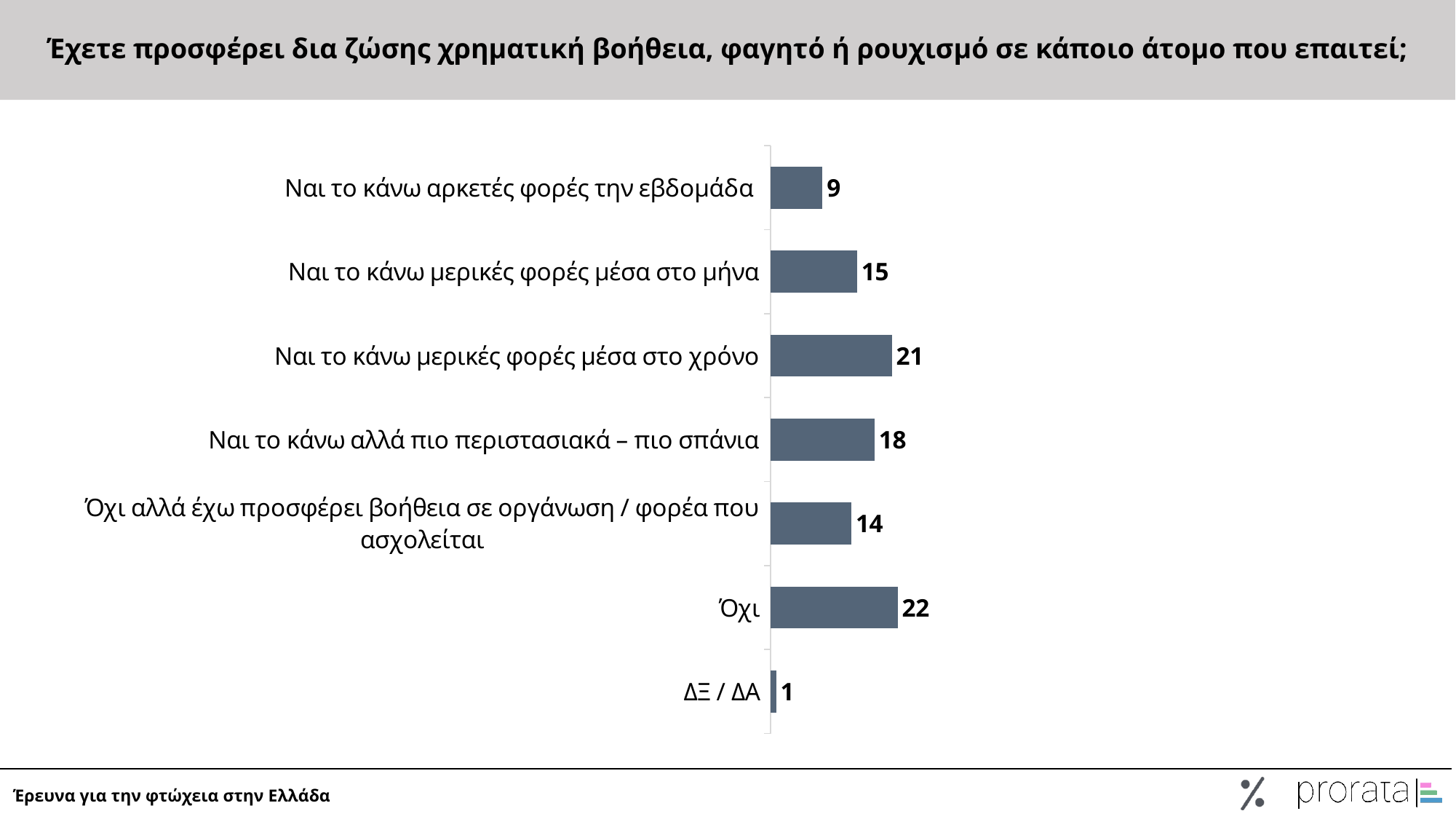
Which category has the highest value? Όχι What is the title of the chart? Έχετε προσφέρει δια ζώσης χρηματική βοήθεια, φαγητό ή ρουχισμό σε κάποιο άτομο που επαιτεί; What kind of chart is shown on the slide? Bar chart What is the difference between the values for 'Όχι' and 'Ναι το κάνω αρκετές φορές την εβδομάδα'? 13 Which is larger: the value for 'Ναι το κάνω αλλά πιο περιστασιακά – πιο σπάνια' or the value for 'Ναι το κάνω μερικές φορές μέσα στο μήνα'? Ναι το κάνω αλλά πιο περιστασιακά – πιο σπάνια How many categories are shown in the chart? 7 Which category has the lowest value? ΔΞ / ΔΑ What is the value for 'Ναι το κάνω μερικές φορές μέσα στο μήνα'? 15 What is the value for 'Ναι το κάνω μερικές φορές μέσα στο χρόνο'? 21 What is the difference between the values for 'Ναι το κάνω μερικές φορές μέσα στο χρόνο' and 'Ναι το κάνω αλλά πιο περιστασιακά – πιο σπάνια'? 3 What is the value for 'Ναι το κάνω αρκετές φορές την εβδομάδα'? 9 What is the value for 'Όχι αλλά έχω προσφέρει βοήθεια σε οργάνωση / φορέα που ασχολείται'? 14